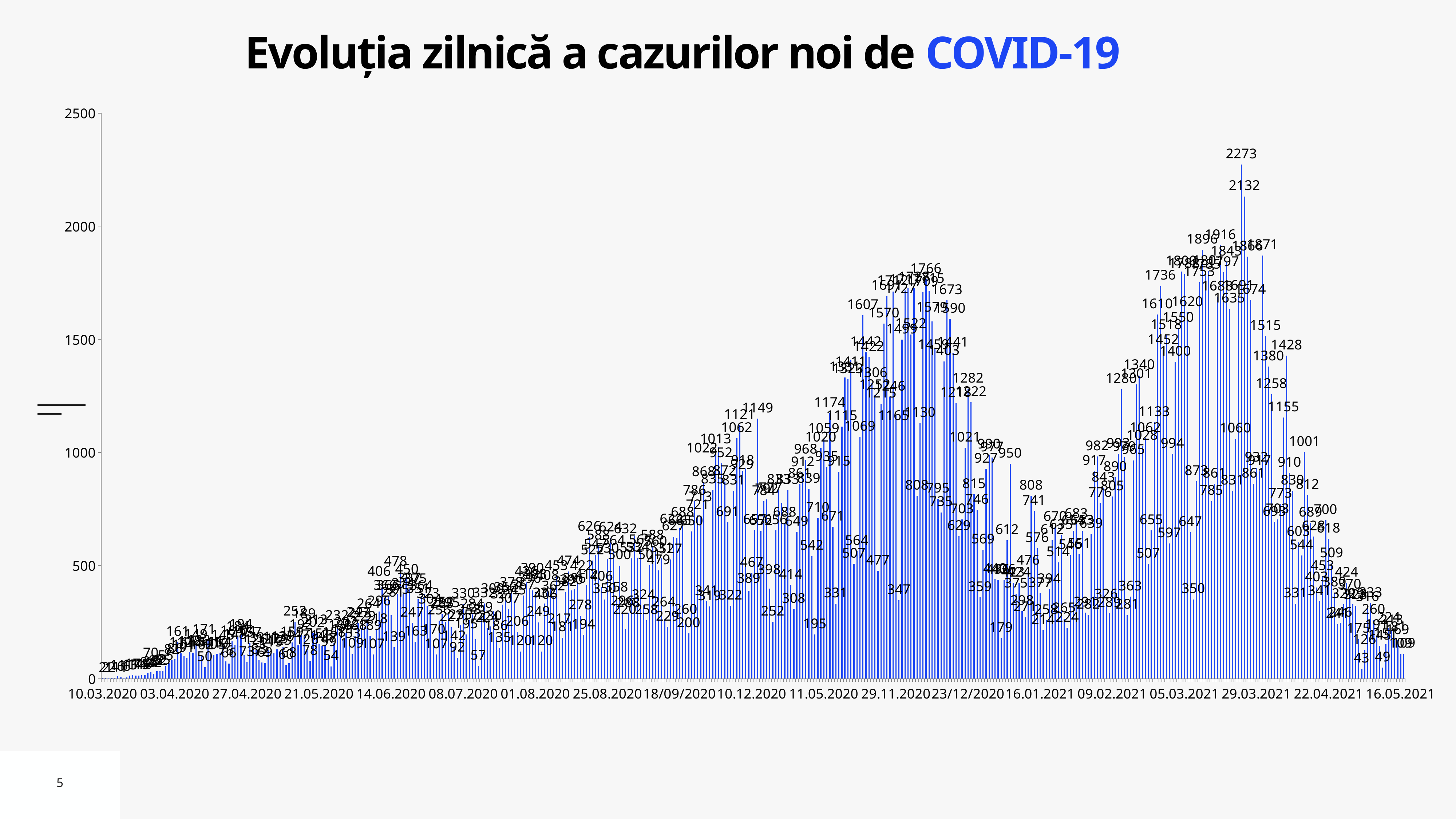
How many date labels are printed along the horizontal axis? 19 What is the second-highest daily value labelled on the chart? 2132 What is the highest daily value labelled on the chart? 2273 Which is larger, the peak labelled 2273 or the peak labelled 2132? 2273 What is the difference between the two highest labelled values, 2273 and 2132? 141 Do the values rise or fall over the final weeks of the chart, approaching 16.05.2021? fall What is the first date label on the horizontal axis? 10.03.2020 What is the maximum value shown on the vertical axis? 2500 What kind of chart is shown on the slide? bar chart What is the title of the chart? Evoluția zilnică a cazurilor noi de COVID-19 What is the last date label on the horizontal axis? 16.05.2021 Is the highest bar on the chart greater or less than 2000? greater